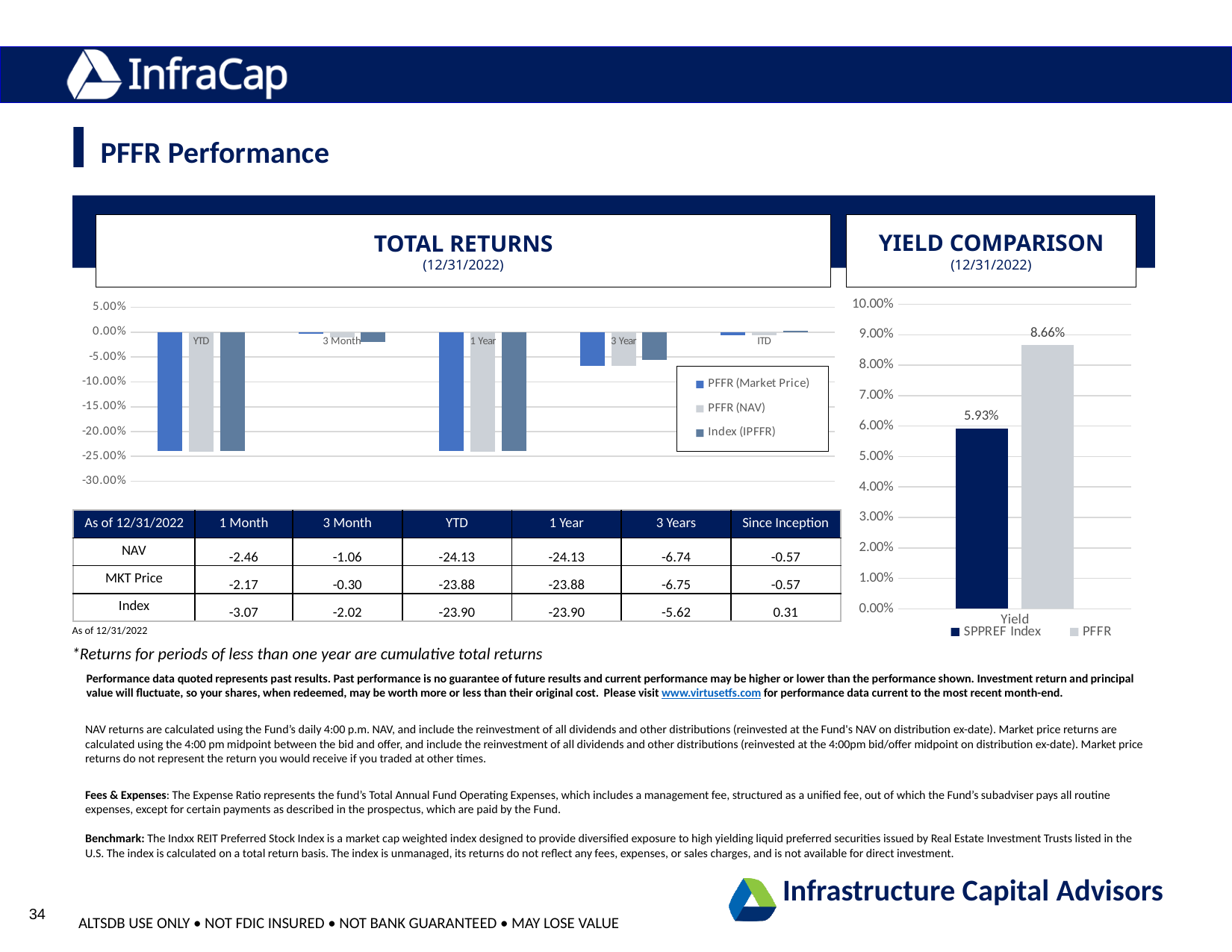
How many period categories are shown on the x axis of the TOTAL RETURNS chart? 5 In the YIELD COMPARISON chart, which series has the higher yield? PFFR In the YIELD COMPARISON chart, what is the yield for the SPPREF Index? 5.93% What kind of chart is the YIELD COMPARISON chart? Bar chart In the TOTAL RETURNS chart, is the YTD value for PFFR (Market Price) greater or less than -20.00%? less In the TOTAL RETURNS chart, which is larger for PFFR (NAV): the 3 Month value or the YTD value? 3 Month What date is shown in the subtitle of the TOTAL RETURNS chart? 12/31/2022 How many series does the legend of the YIELD COMPARISON chart list? 2 How many series does the legend of the TOTAL RETURNS chart list? 3 In the YIELD COMPARISON chart, what is the yield for PFFR? 8.66% In the TOTAL RETURNS chart, is the 3 Year value for Index (IPFFR) greater or less than -10.00%? greater In the YIELD COMPARISON chart, what is the difference between the PFFR yield and the SPPREF Index yield? 2.73%